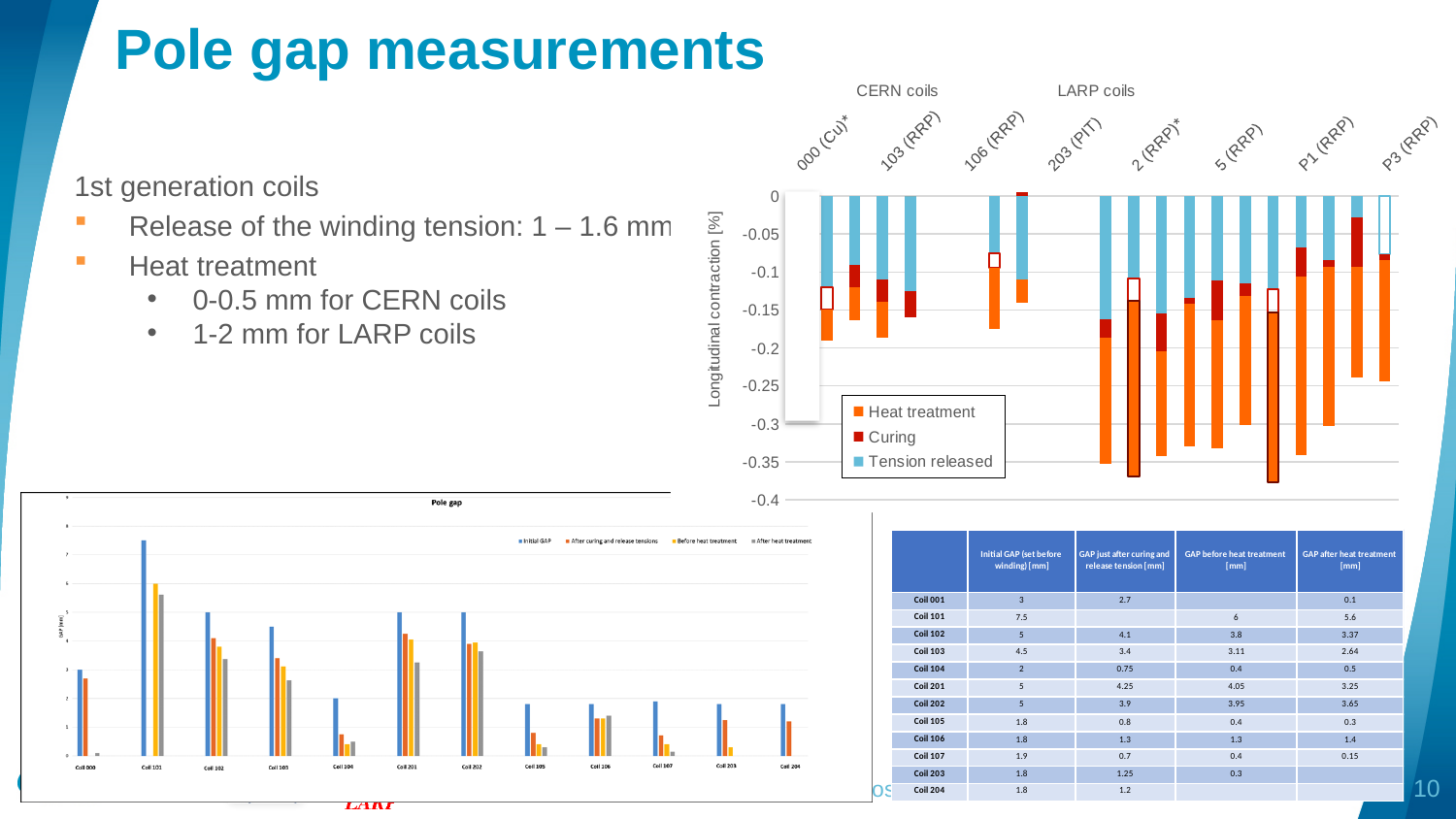
In the Longitudinal contraction chart, is the bottom of the stacked bar for 103 (RRP) greater or less than -0.2? greater In the Longitudinal contraction chart, is the bottom of the stacked bar for 2 (RRP)* greater or less than -0.3? less In the Longitudinal contraction chart, what is the label of the y axis? Longitudinal contraction [%] How many series does the legend of the Pole gap chart list? 4 How many series does the legend of the Longitudinal contraction chart list? 3 What type of chart is the Pole gap chart in the bottom left of the slide? bar chart What type of chart is the chart in the top right of the slide (Longitudinal contraction)? bar chart In the Pole gap chart, which coil has the highest Initial GAP value? Coil 101 In the Pole gap chart, is the Initial GAP value for Coil 101 greater or less than 7? greater In the Longitudinal contraction chart, which series is shown in light blue? Tension released How many coil categories are shown on the x axis of the Pole gap chart? 12